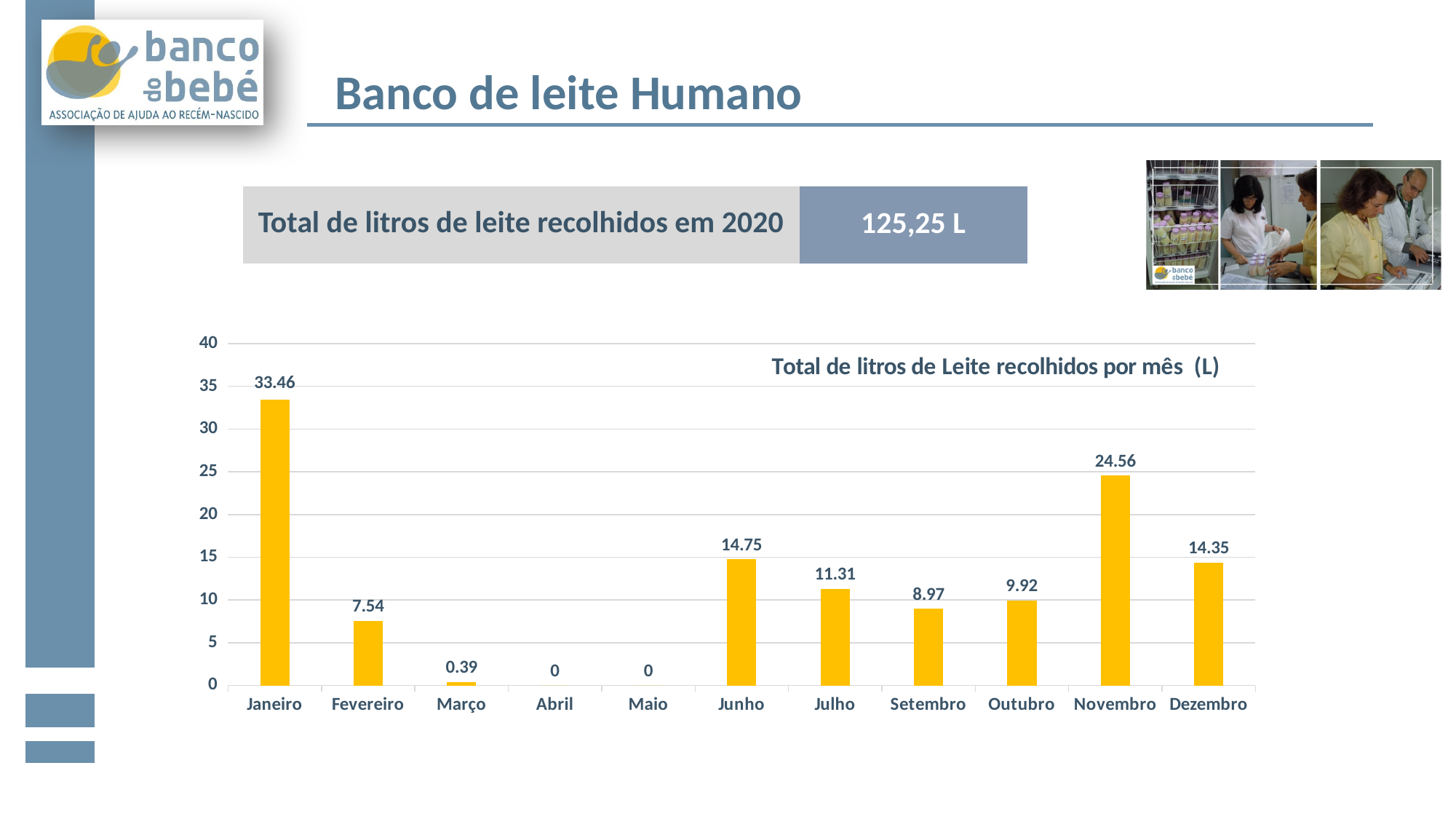
What is the value for Novembro in the chart? 24.56 What is the value for Setembro in the chart? 8.97 What is the value for Janeiro in the chart? 33.46 What is the title of the chart? Total de litros de Leite recolhidos por mês (L) How many months are shown on the x axis of the chart? 11 What is the value for Março in the chart? 0.39 Is the value for Outubro greater or less than 10? less Which months have a value of 0 in the chart? Abril and Maio What is the difference between the values for Janeiro and Novembro? 8.90 What type of chart is shown on the slide? bar chart Which is larger, the value for Junho or the value for Dezembro? Junho Which month has the highest value in the chart? Janeiro